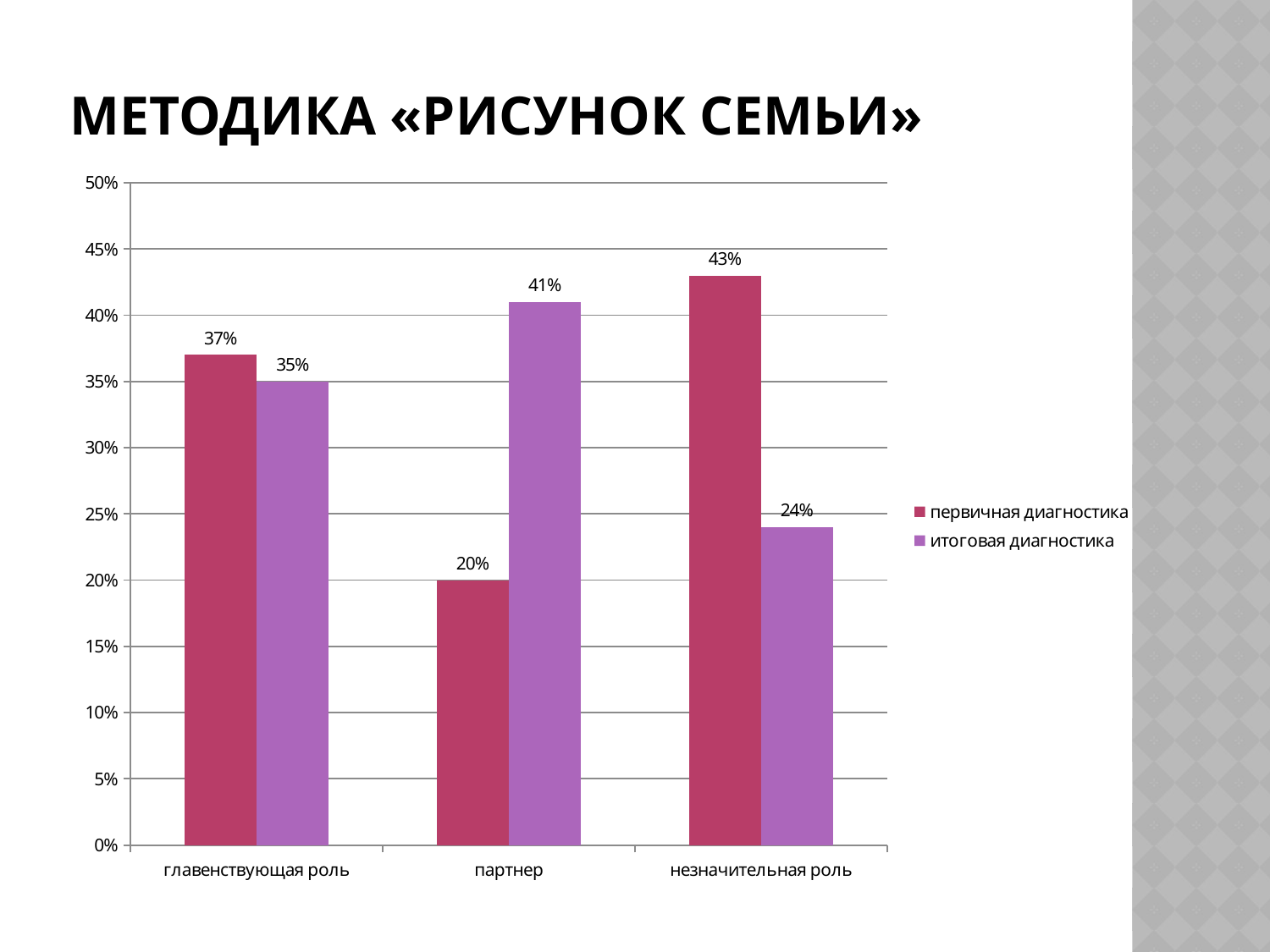
What is the value for "итоговая диагностика" in the "незначительная роль" category? 24% What is the value for "итоговая диагностика" in the "партнер" category? 41% What is the difference between "первичная диагностика" and "итоговая диагностика" in the "незначительная роль" category? 19% Which category has the highest value for "первичная диагностика"? незначительная роль How many series does the legend list? 2 Which category has the lowest value for "итоговая диагностика"? незначительная роль What is the value for "первичная диагностика" in the "главенствующая роль" category? 37% In the "главенствующая роль" category, which series has the larger value? первичная диагностика How many categories are shown on the x axis? 3 What kind of chart is shown on the slide? bar chart Is the value for "первичная диагностика" in the "партнер" category greater or less than 25%? less What is the difference between "итоговая диагностика" and "первичная диагностика" in the "партнер" category? 21%